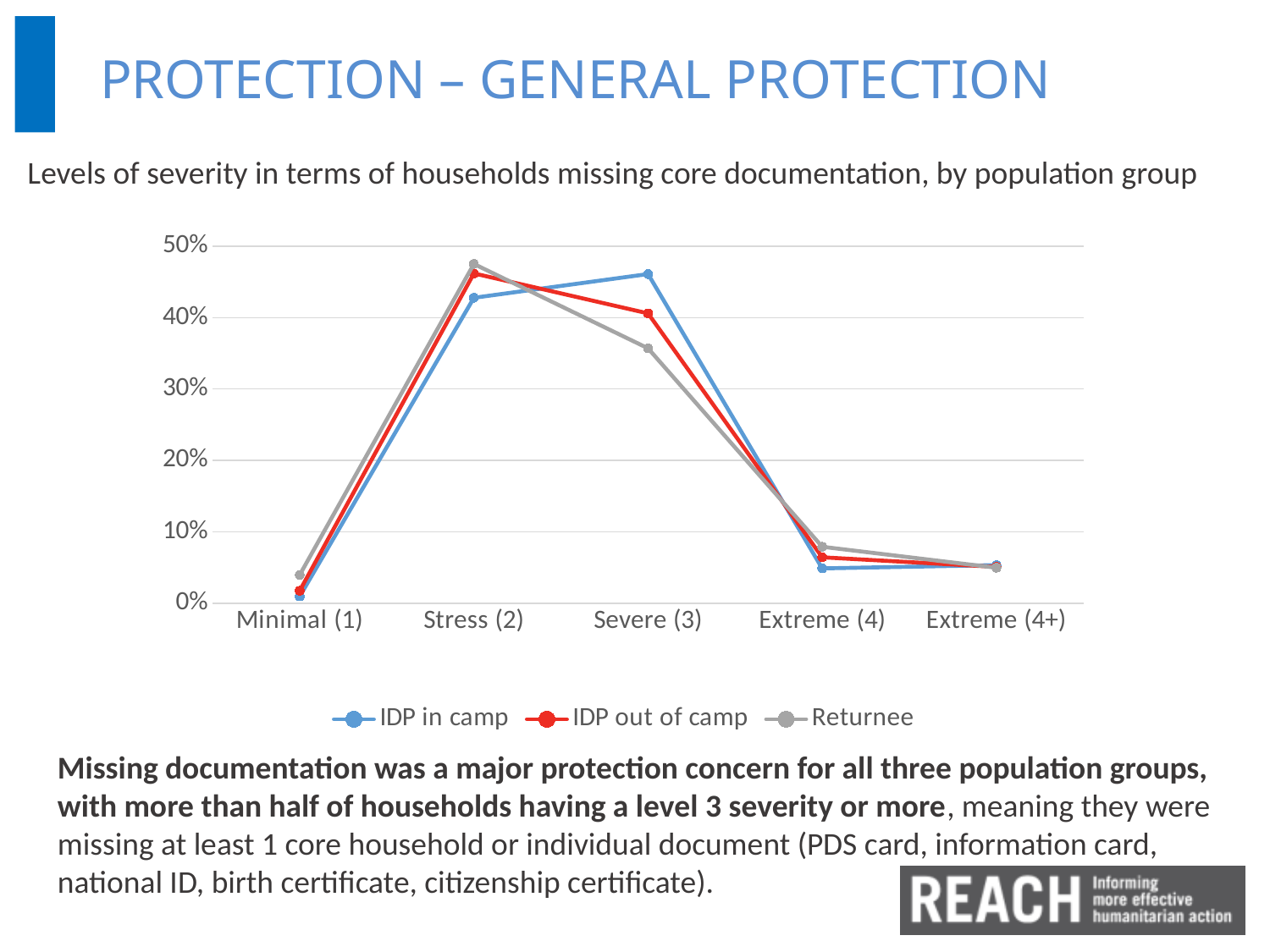
What kind of chart is shown on the slide? line chart At Minimal (1), which series has the higher value: Returnee or IDP in camp? Returnee How many severity categories are shown on the x axis? 5 For the Returnee series, which severity category has the highest value? Stress (2) Is the value for Returnee at Severe (3) greater or less than 40%? less Do the values for all three series rise or fall from Severe (3) to Extreme (4)? fall At Severe (3), which series has the higher value: IDP in camp or Returnee? IDP in camp Is the value for IDP out of camp at Extreme (4) greater or less than 10%? less How many series does the legend list? 3 Is the value for IDP in camp at Severe (3) greater or less than 40%? greater For the IDP in camp series, which severity category has the highest value? Severe (3) For the IDP in camp series, which severity category has the lowest value? Minimal (1)